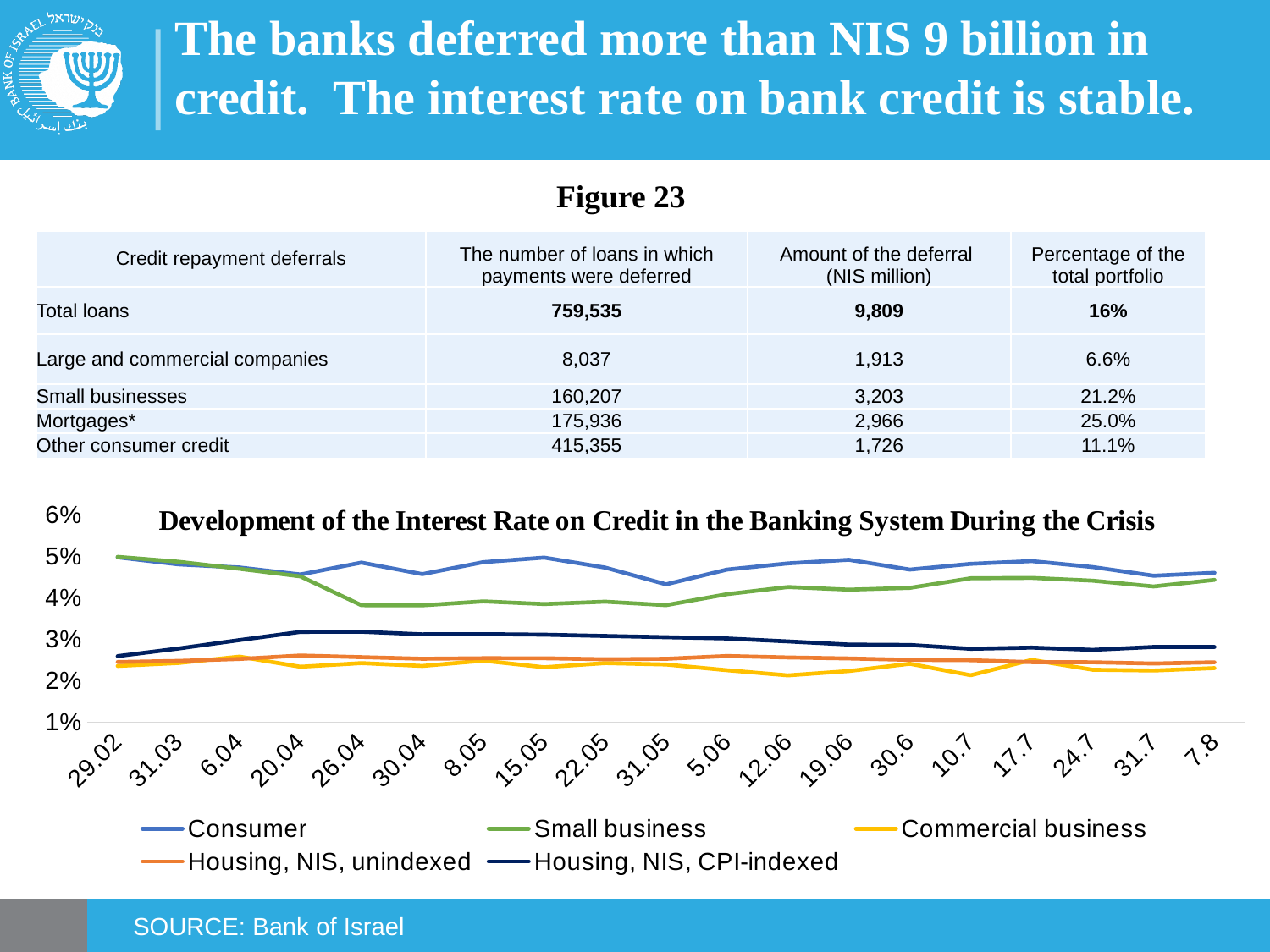
In the interest rate chart, which is larger at 7.8: Small business or Housing, NIS, CPI-indexed? Small business In the interest rate chart, what colour is the Commercial business line? yellow In the interest rate chart, which series has the lowest value at 12.06? Commercial business In the interest rate chart, which series has the highest interest rate across the period? Consumer How many dates are shown on the x axis of the interest rate chart? 19 In the interest rate chart, is the Commercial business value at 12.06 greater or less than 3%? less What is the title of the line chart on the slide? Development of the Interest Rate on Credit in the Banking System During the Crisis In the interest rate chart, is the Small business value at 26.04 greater or less than 4%? less How many series does the legend of the interest rate chart list? 5 In the interest rate chart, is the Consumer value at 29.02 greater or less than 4%? greater In the interest rate chart, does the Small business line rise or fall between 29.02 and 26.04? fall What kind of chart is "Development of the Interest Rate on Credit in the Banking System During the Crisis"? line chart